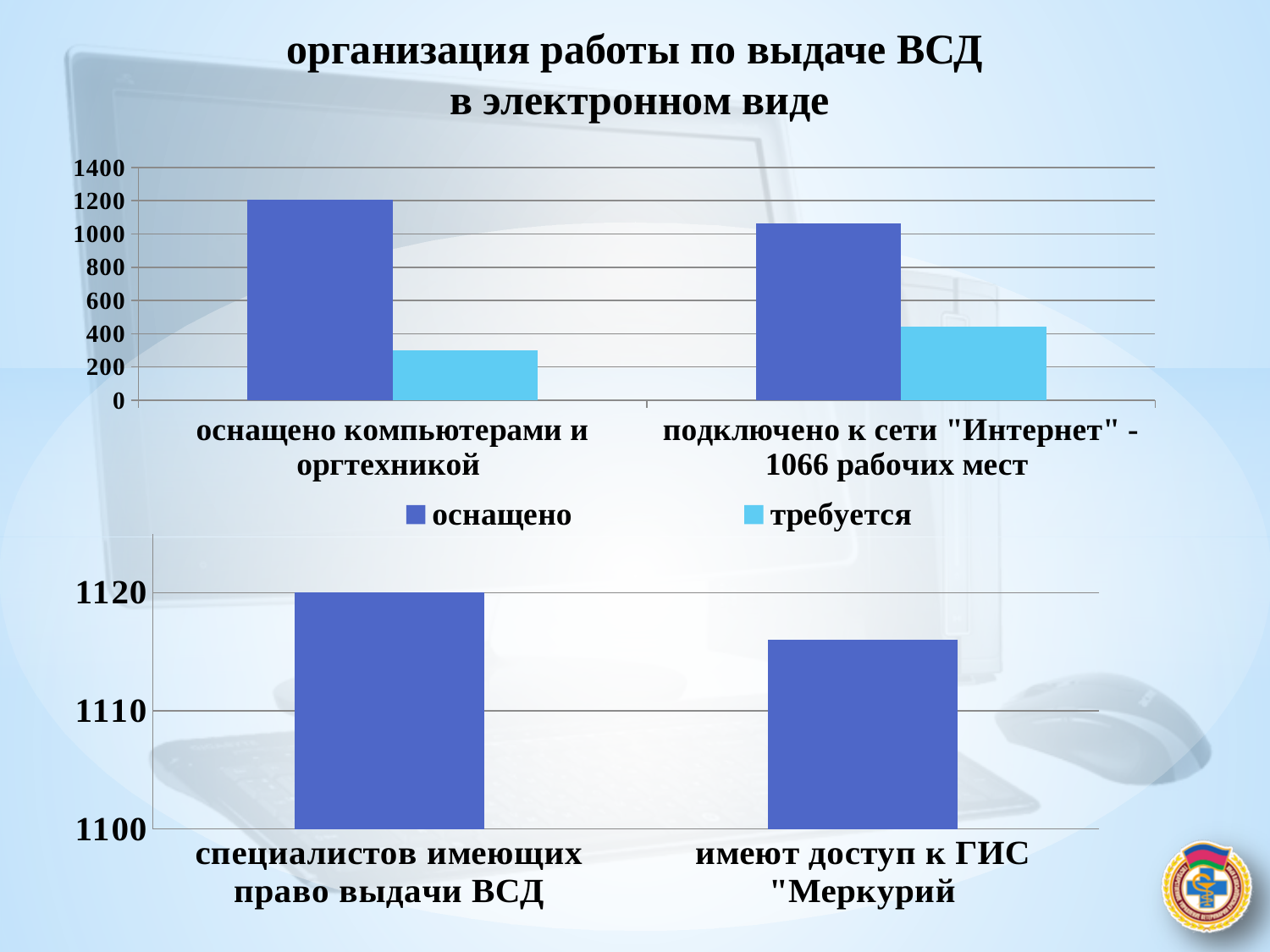
In the bottom chart, which category has the lower value? имеют доступ к ГИС "Меркурий In the bottom chart, what is the value for 'специалистов имеющих право выдачи ВСД'? 1120 In the top chart, is the value of 'требуется' for 'подключено к сети "Интернет"' greater or less than 400? greater In the top chart, which category has the higher 'оснащено' value? оснащено компьютерами и оргтехникой In the top chart, what are the two legend entries? оснащено, требуется In the top chart, is the value of 'требуется' for 'оснащено компьютерами и оргтехникой' greater or less than 400? less What kind of chart is the top chart on the slide? bar chart In the top chart, which series has the larger value for 'подключено к сети "Интернет"': 'оснащено' or 'требуется'? оснащено How many series does the legend of the top chart list? 2 In the top chart, how many categories are shown on the x axis? 2 What kind of chart is the bottom chart on the slide? bar chart